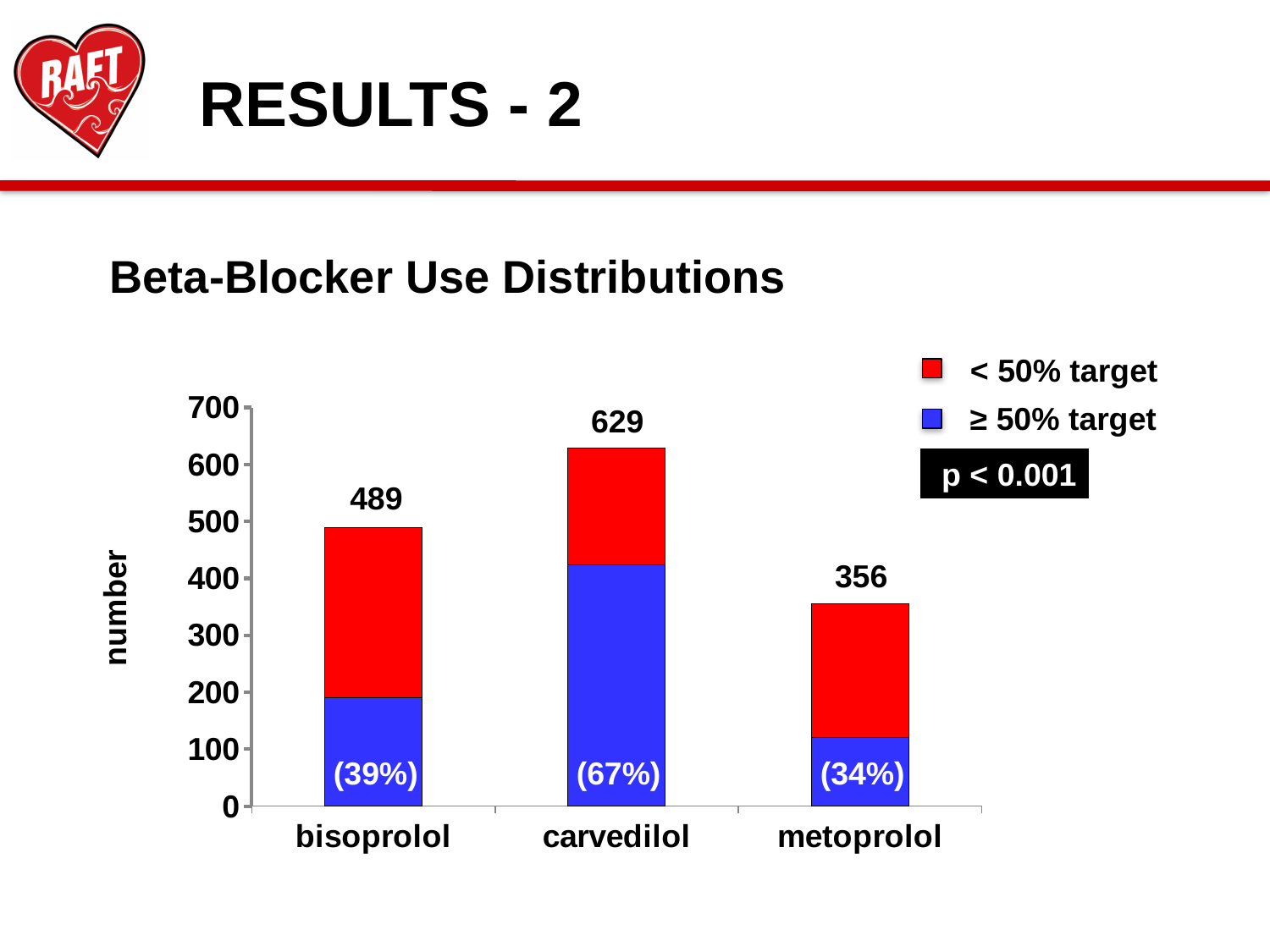
What is the total number shown for bisoprolol? 489 What is the total number shown for metoprolol? 356 Which beta-blocker has the highest total number? carvedilol Which beta-blocker has the lowest total number? metoprolol How many beta-blockers are shown on the x axis? 3 What percentage is printed inside the bar for metoprolol? (34%) What is the difference between the total for carvedilol and the total for bisoprolol? 140 Which has a larger total number, bisoprolol or metoprolol? bisoprolol What percentage is printed inside the bar for carvedilol? (67%) What is the total number shown for carvedilol? 629 How many series does the legend list? 2